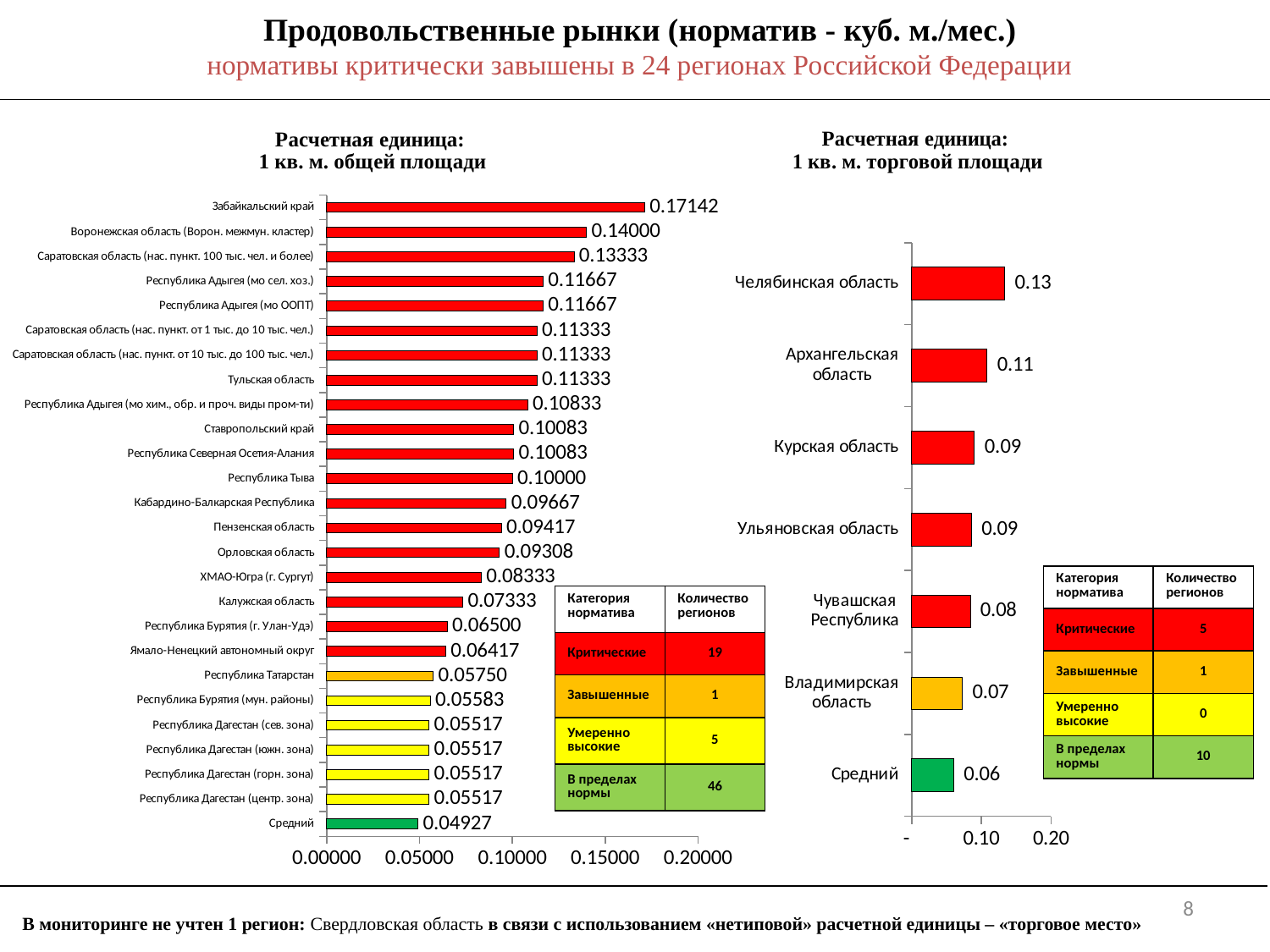
In the right chart (1 кв. м. торговой площади), is the value for Архангельская область greater or less than 0.10? greater In the left chart (1 кв. м. общей площади), which is larger: Республика Татарстан or Калужская область? Калужская область In the right chart (1 кв. м. торговой площади), how many bars are plotted? 7 What type of chart is used on the right side of the slide (1 кв. м. торговой площади)? Bar chart In the right chart (1 кв. м. торговой площади), which category has the lowest value? Средний In the left chart (1 кв. м. общей площади), what is the value for Средний? 0.04927 In the left chart (1 кв. м. общей площади), what is the difference between Забайкальский край and Воронежская область (Ворон. межмун. кластер)? 0.03142 In the left chart (1 кв. м. общей площади), which category has the highest value? Забайкальский край In the right chart (1 кв. м. торговой площади), what is the difference between Челябинская область and Владимирская область? 0.06 In the left chart (1 кв. м. общей площади), what is the value for Забайкальский край? 0.17142 In the left chart (1 кв. м. общей площади), what is the value for Ямало-Ненецкий автономный округ? 0.06417 In the right chart (1 кв. м. торговой площади), what is the value for Челябинская область? 0.13